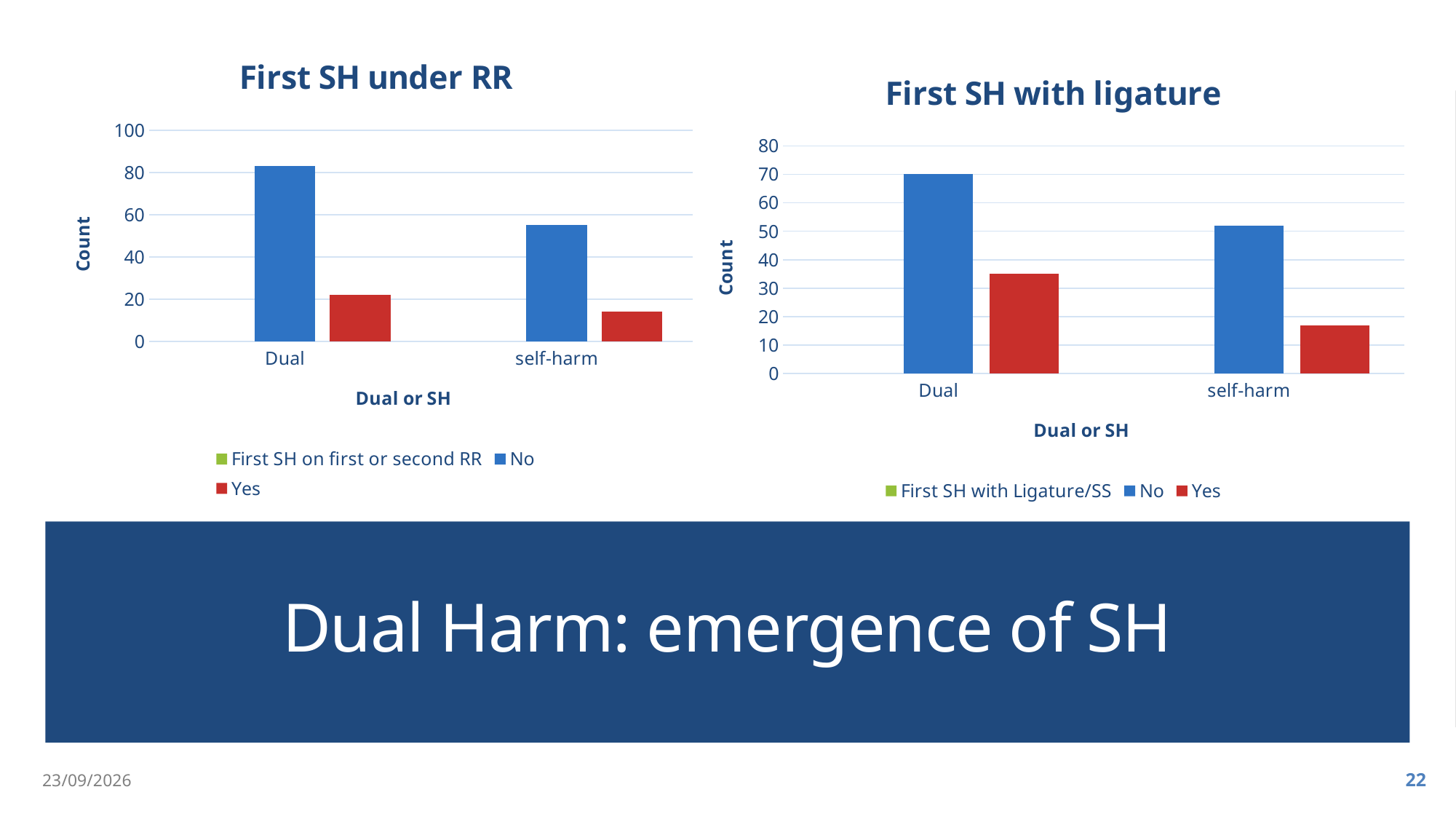
In the "First SH under RR" chart, which bar is the shortest? Yes for self-harm In the "First SH with ligature" chart, is the "No" value for self-harm greater or less than 60? less In the "First SH with ligature" chart, which is larger: the "Yes" value for Dual or the "Yes" value for self-harm? Yes for Dual In the "First SH under RR" chart, which bar is the tallest? No for Dual What kind of chart is the "First SH under RR" chart? bar chart In the "First SH under RR" chart, is the "No" value for Dual greater or less than 80? greater In the "First SH under RR" chart, is the "Yes" value for self-harm greater or less than 20? less In the "First SH with ligature" chart, does the "No" series rise or fall from Dual to self-harm? fall What is the label on the x axis of the "First SH with ligature" chart? Dual or SH In the "First SH under RR" chart, how many categories are shown on the x axis? 2 How many entries does the legend of the "First SH with ligature" chart list? 3